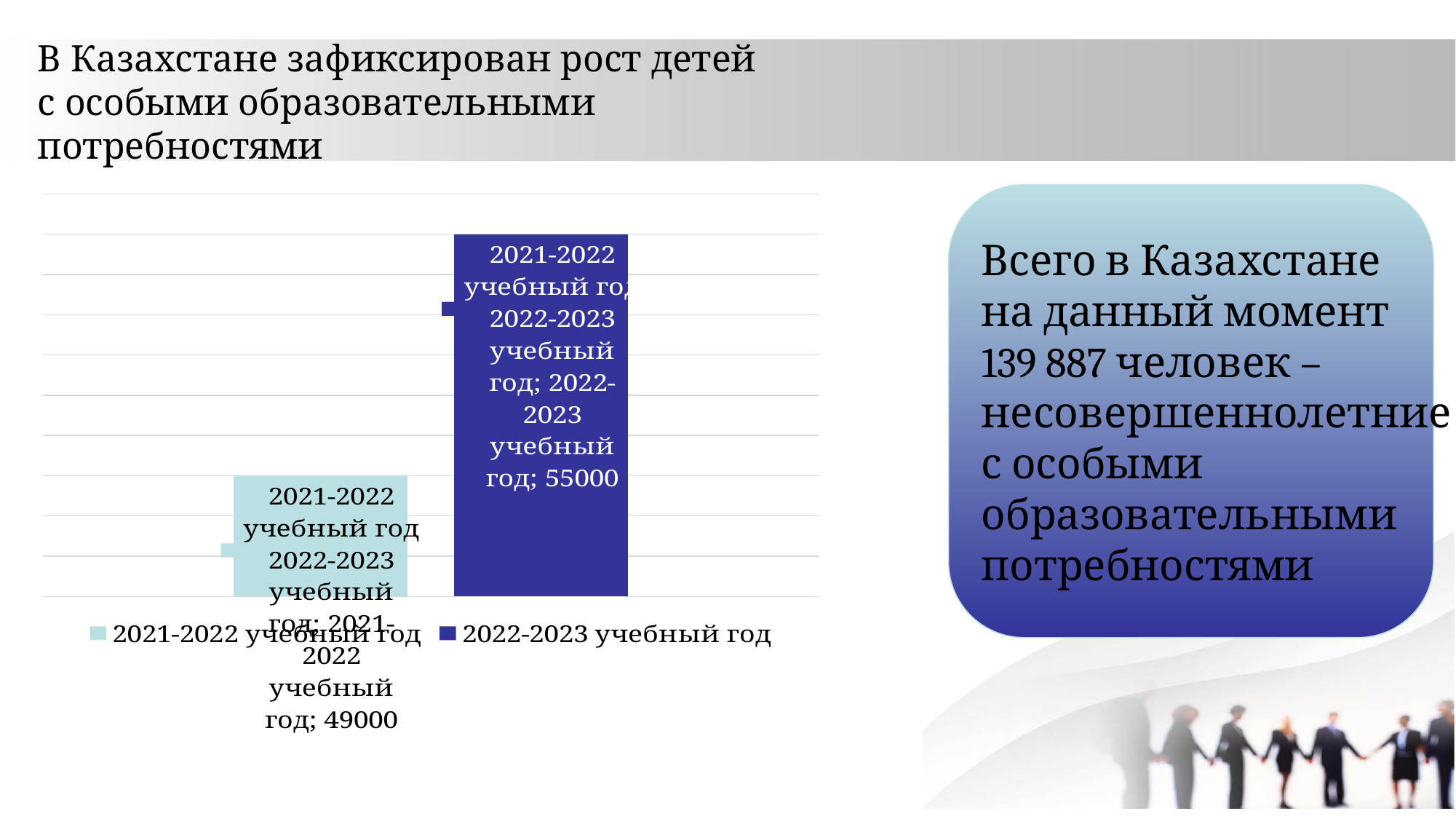
Do the values rise or fall from the 2021-2022 учебный год bar to the 2022-2023 учебный год bar? rise What colour is the bar for 2022-2023 учебный год? dark blue How many bars are plotted in the chart? 2 What is the difference between the values for 2022-2023 учебный год and 2021-2022 учебный год? 6000 What is the value for the 2022-2023 учебный год series? 55000 Which series has the highest value in the chart? 2022-2023 учебный год What is the first entry listed in the chart legend? 2021-2022 учебный год What is the value for the 2021-2022 учебный год series? 49000 What type of chart is shown on the slide? bar chart Which series has the lowest value in the chart? 2021-2022 учебный год Which series has the higher value, 2021-2022 учебный год or 2022-2023 учебный год? 2022-2023 учебный год How many series does the legend list? 2